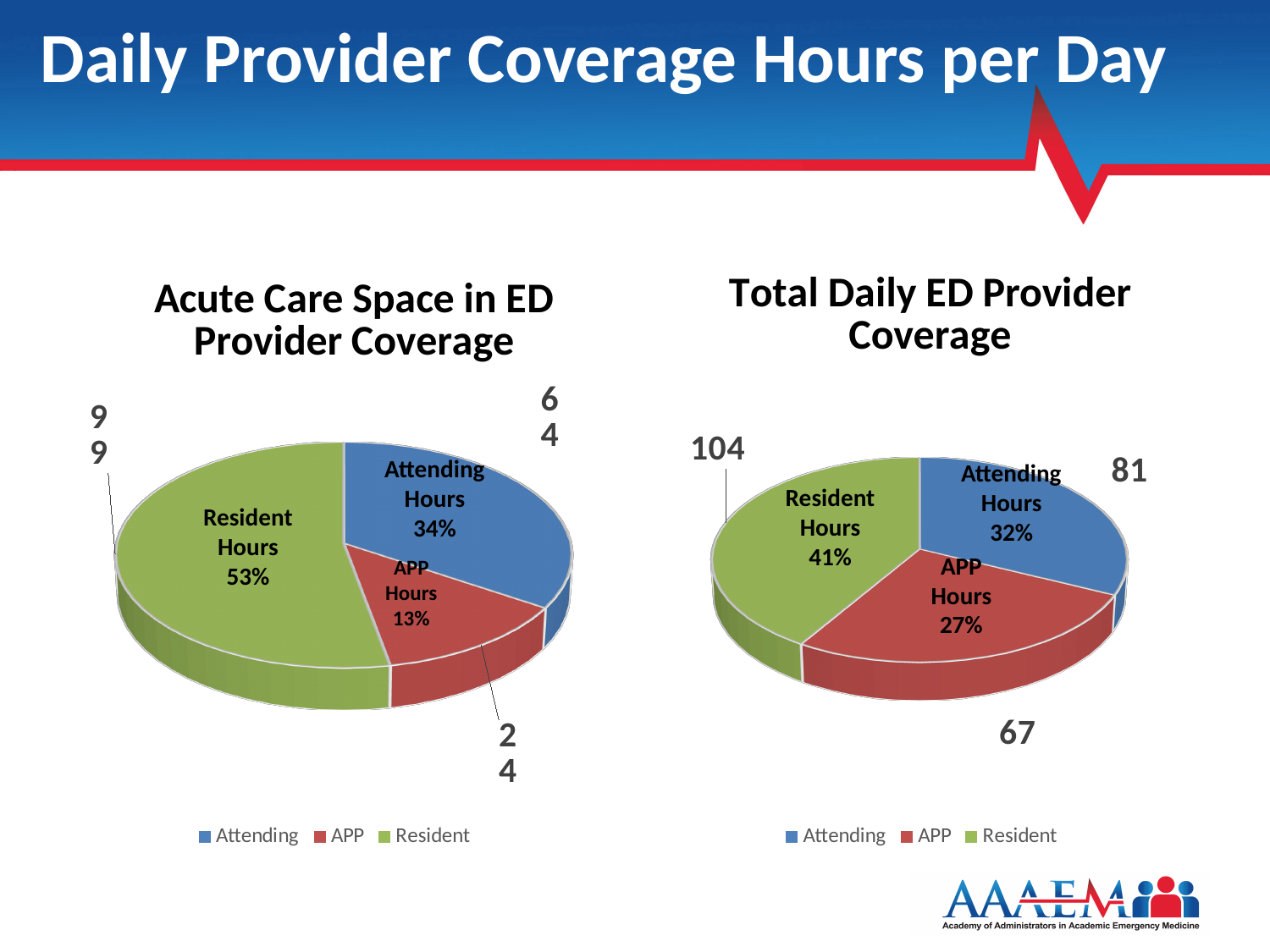
In the "Total Daily ED Provider Coverage" chart, what share of the pie is Attending Hours? 32% In the "Acute Care Space in ED Provider Coverage" chart, what share of the pie is Resident Hours? 53% In the "Acute Care Space in ED Provider Coverage" chart, what share of the pie is APP Hours? 13% In the "Acute Care Space in ED Provider Coverage" chart, which slice is the smallest? APP Hours How many slices does the "Total Daily ED Provider Coverage" pie chart have? 3 How many entries does the legend of the "Acute Care Space in ED Provider Coverage" chart list? 3 In the "Total Daily ED Provider Coverage" chart, which is larger, the Attending Hours slice or the APP Hours slice? Attending Hours In the "Total Daily ED Provider Coverage" chart, what value is shown for APP Hours? 67 What kind of chart is the "Acute Care Space in ED Provider Coverage" chart? Pie chart In the "Acute Care Space in ED Provider Coverage" chart, which slice is the largest? Resident Hours In the "Total Daily ED Provider Coverage" chart, what value is shown for Resident Hours? 104 In the "Total Daily ED Provider Coverage" chart, what is the difference between the Resident Hours value and the Attending Hours value? 23